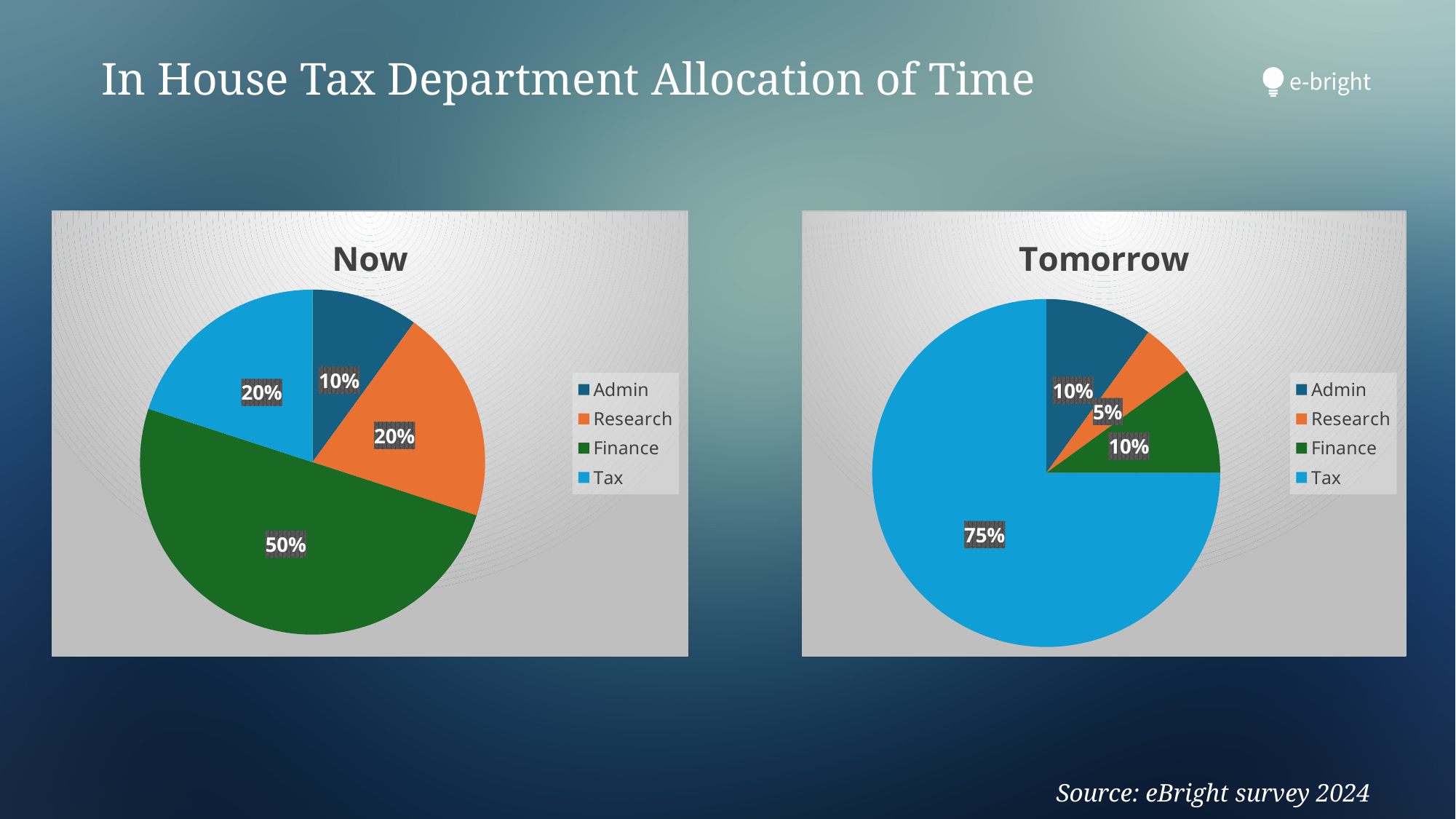
In the "Now" chart, what share of time is allocated to Finance? 50% In the "Now" chart, what share of time is allocated to Admin? 10% In the "Now" chart, which category has the smallest share? Admin In the "Tomorrow" chart, what colour represents Tax? Light blue In the "Tomorrow" chart, what share of time is allocated to Research? 5% How many categories does the "Tomorrow" chart show? 4 What kind of chart is the "Now" chart? Pie chart In the "Tomorrow" chart, which category has the smallest share? Research In the "Tomorrow" chart, what share of time is allocated to Tax? 75% In the "Now" chart, which is larger: the share for Research or the share for Admin? Research In the "Now" chart, which category has the largest share? Finance What is the difference between the Tax share in the "Tomorrow" chart and the Tax share in the "Now" chart? 55%